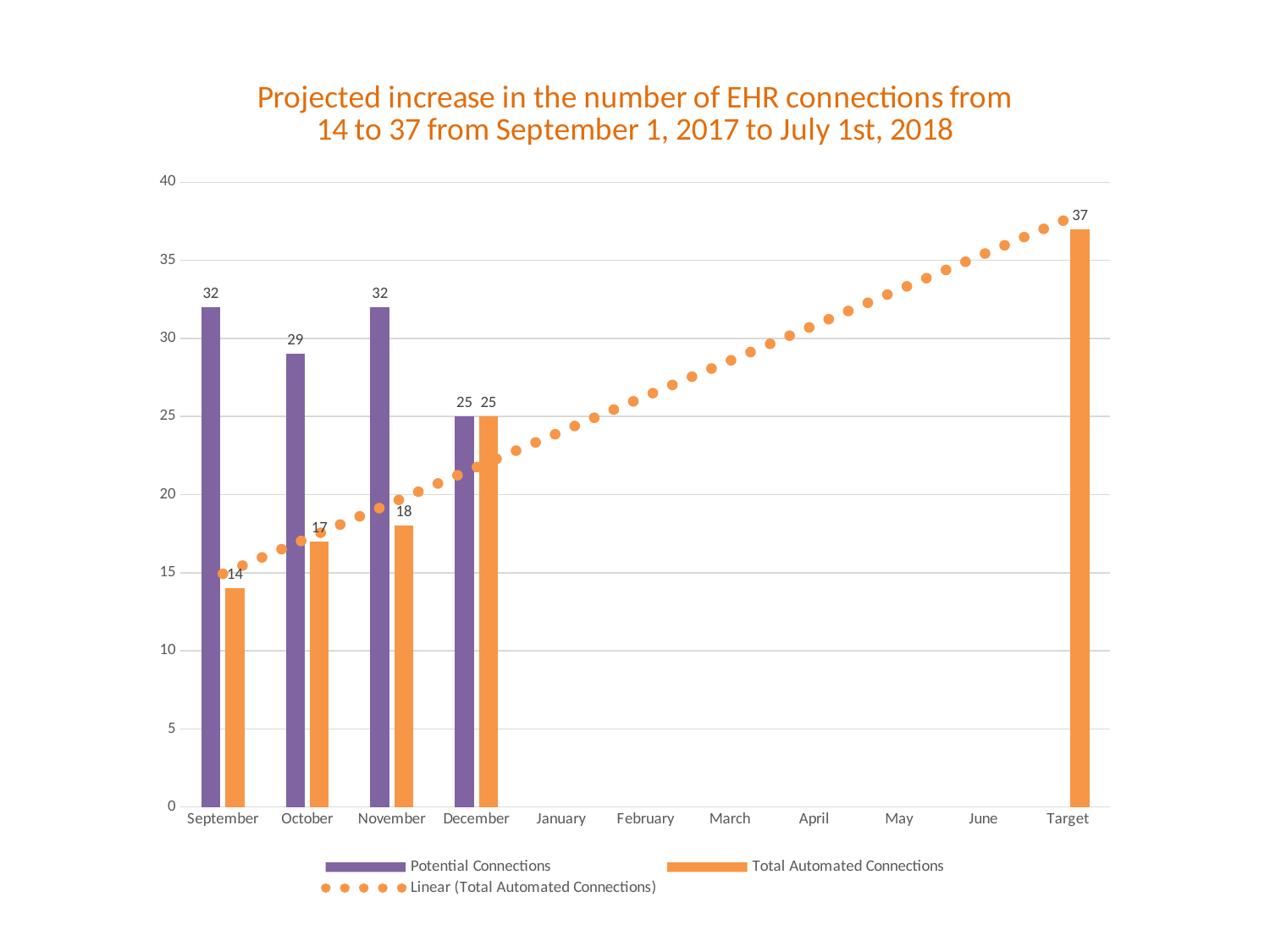
What is the value of Total Automated Connections for the Target category? 37 Do the Total Automated Connections values rise or fall from September to December? rise Which month has the lowest value for Potential Connections? December What is the difference between the Target value and the September value for Total Automated Connections? 23 Which month has the lowest value for Total Automated Connections? September What is the value of Total Automated Connections for September? 14 What is the difference between Potential Connections and Total Automated Connections in November? 14 What is the value of Potential Connections for October? 29 How many categories are shown on the x axis? 11 How many entries does the legend list? 3 Is the Total Automated Connections value for December greater or less than 20? greater Which is larger in October: Potential Connections or Total Automated Connections? Potential Connections